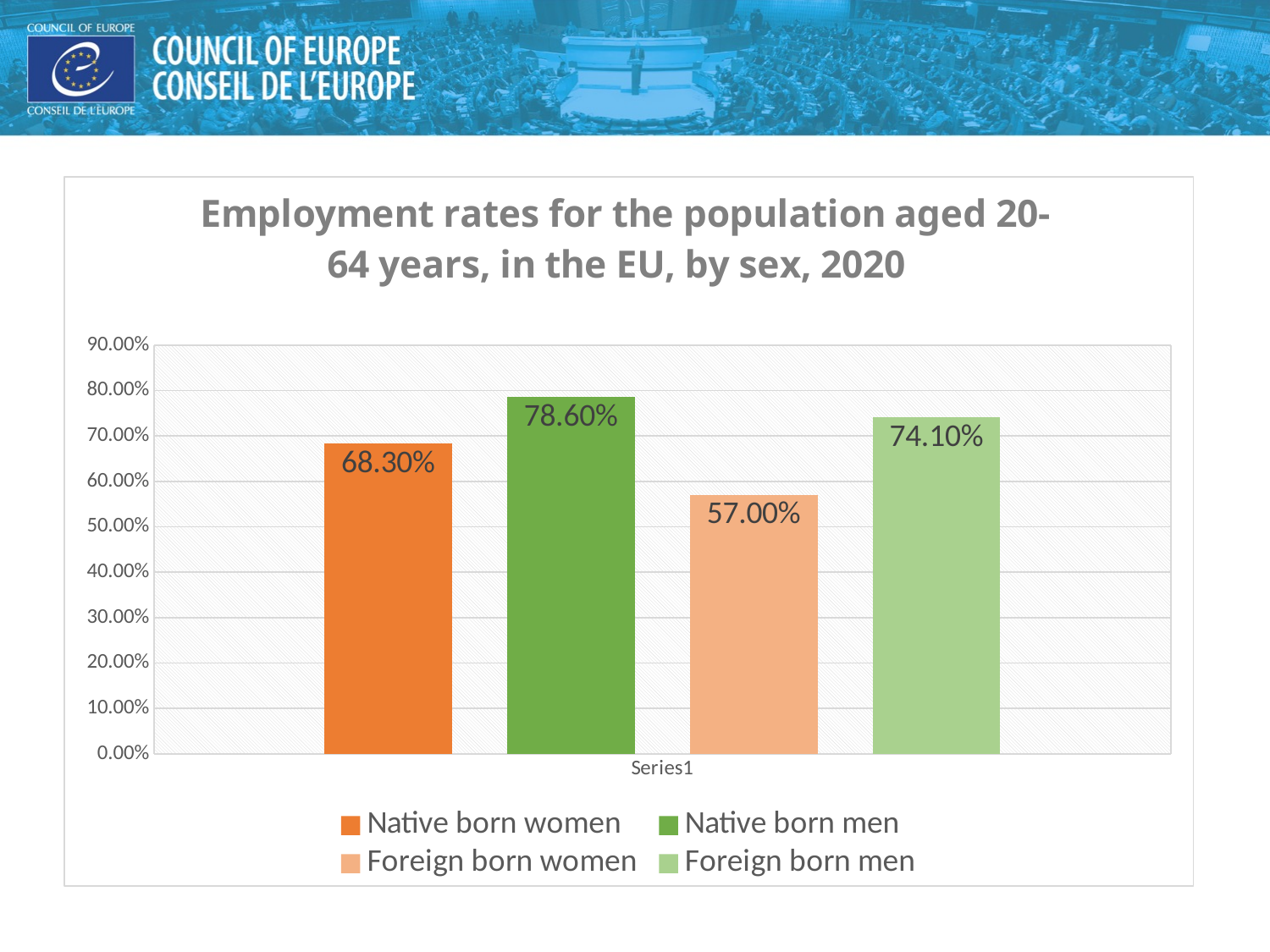
What is the employment rate for native born women? 68.30% How many series does the legend list? 4 What is the difference between the employment rates of foreign born men and foreign born women? 17.10% What is the employment rate for foreign born men? 74.10% Which is larger, the employment rate for native born women or for foreign born men? Foreign born men What is the employment rate for foreign born women? 57.00% Which group has the highest employment rate? Native born men What kind of chart is shown on the slide? Bar chart What is the difference between the employment rates of native born men and native born women? 10.30% What is the employment rate for native born men? 78.60% What is the title of the chart? Employment rates for the population aged 20-64 years, in the EU, by sex, 2020 Which group has the lowest employment rate? Foreign born women